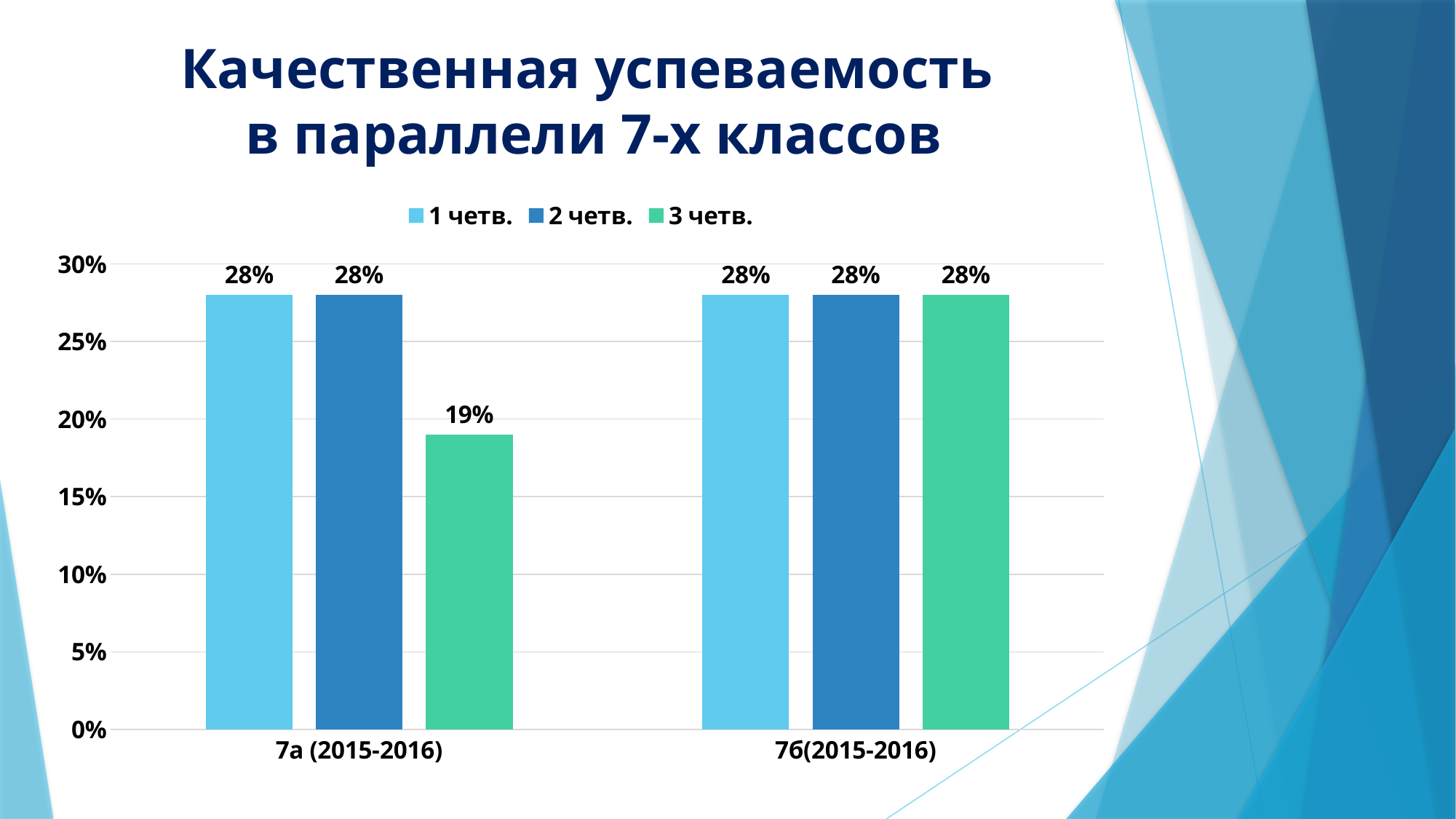
What is the value for 3 четв. in the 7а (2015-2016) category? 19% What is the title of the slide? Качественная успеваемость в параллели 7-х классов Is the value for 3 четв. in 7а (2015-2016) greater or less than 20%? less What is the value for 2 четв. in the 7а (2015-2016) category? 28% Which is larger: the 3 четв. value for 7а (2015-2016) or for 7б(2015-2016)? 7б(2015-2016) Is the value for 1 четв. in 7а (2015-2016) greater or less than 25%? greater What is the difference between the 3 четв. values for 7б(2015-2016) and 7а (2015-2016)? 9% How many series does the legend list? 3 What kind of chart is shown on the slide? bar chart What is the value for 1 четв. in the 7б(2015-2016) category? 28% Which series has the lowest value in the 7а (2015-2016) category? 3 четв. How many categories are shown on the x axis? 2